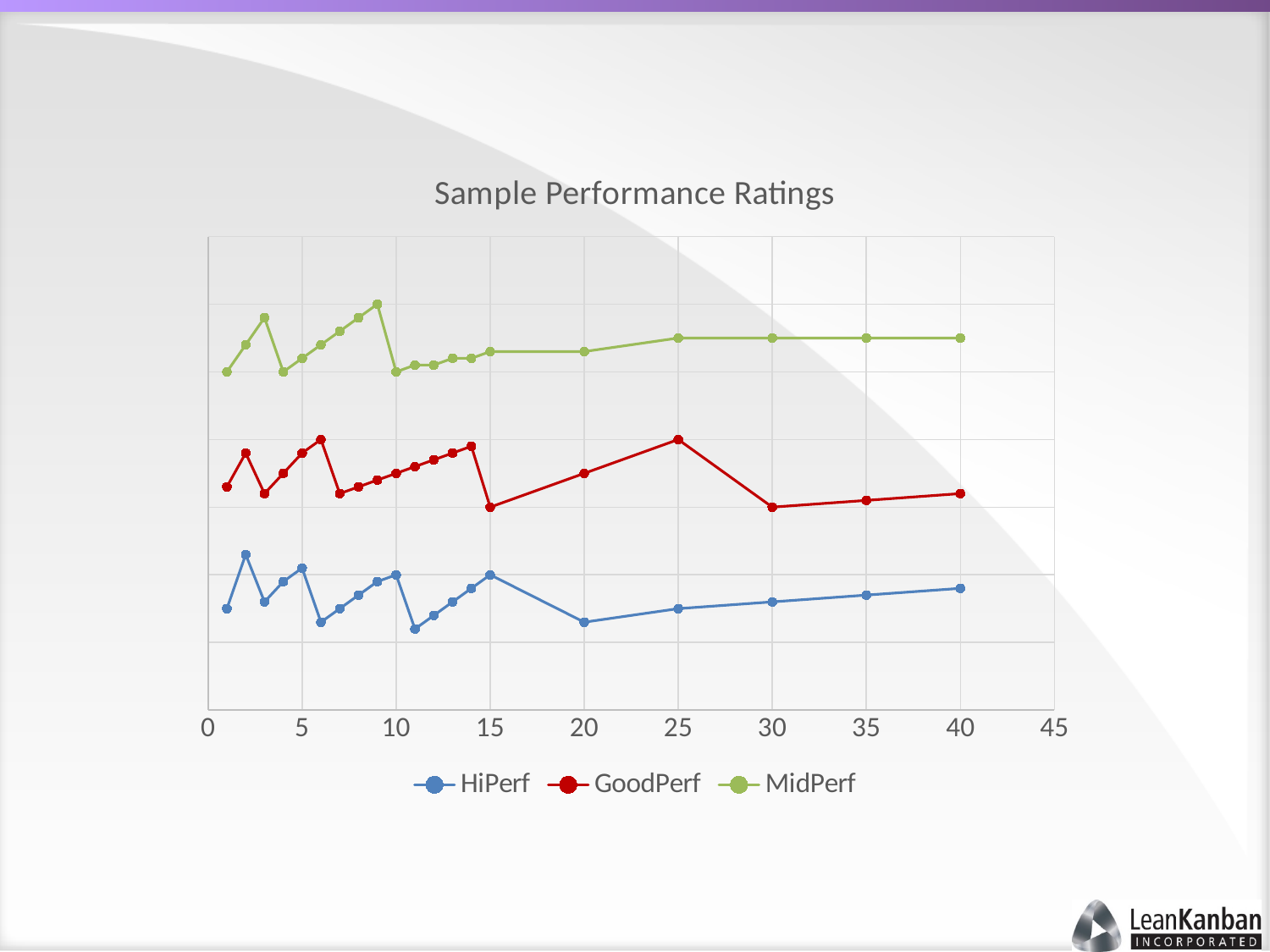
What is the largest value labelled on the x axis? 45 At x = 40, which is higher, MidPerf or GoodPerf? MidPerf How many series does the legend list? 3 Does the HiPerf series rise or fall between x = 20 and x = 40? rise Which series is plotted highest on the chart? MidPerf How many data points does the HiPerf series have? 20 Which series is plotted lowest on the chart? HiPerf At x = 25, which is higher, GoodPerf or HiPerf? GoodPerf What is the title of the chart? Sample Performance Ratings What kind of chart is shown on the slide? line chart Does the GoodPerf series rise or fall between x = 25 and x = 30? fall Which colour is used for the GoodPerf series? red